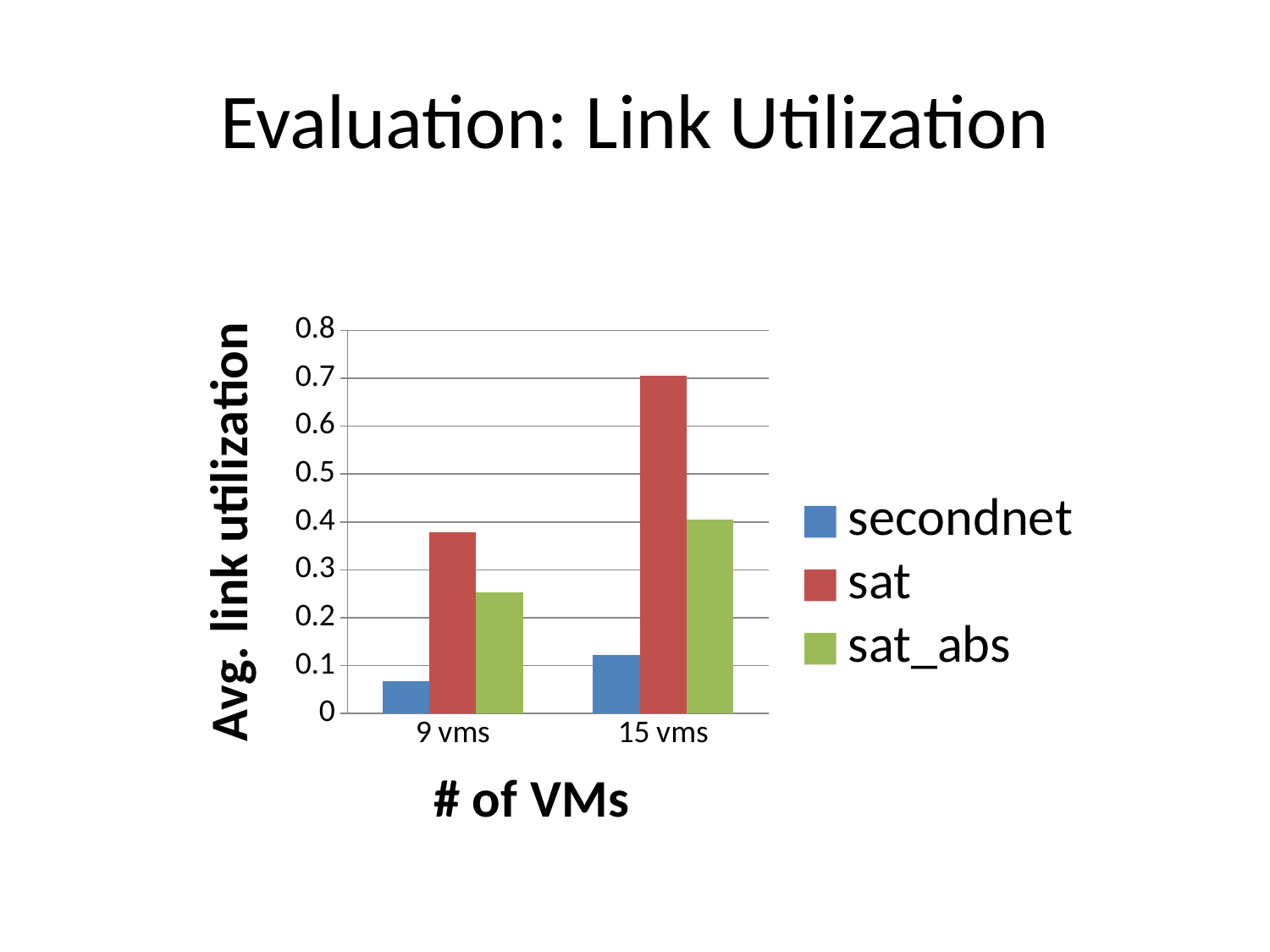
Does the average link utilization for sat rise or fall from 9 vms to 15 vms? rise Which is larger: sat_abs at 9 vms or sat_abs at 15 vms? sat_abs at 15 vms What is the label of the y axis? Avg. link utilization How many categories are shown on the x axis? 2 Is the value for sat at 9 vms greater or less than 0.5? less Which series has the lowest average link utilization at 9 vms? secondnet Which series has the highest average link utilization at 15 vms? sat How many series does the legend list? 3 Is the value for sat at 15 vms greater or less than 0.6? greater Is the value for secondnet at 9 vms greater or less than 0.1? less What kind of chart is shown on the slide? bar chart